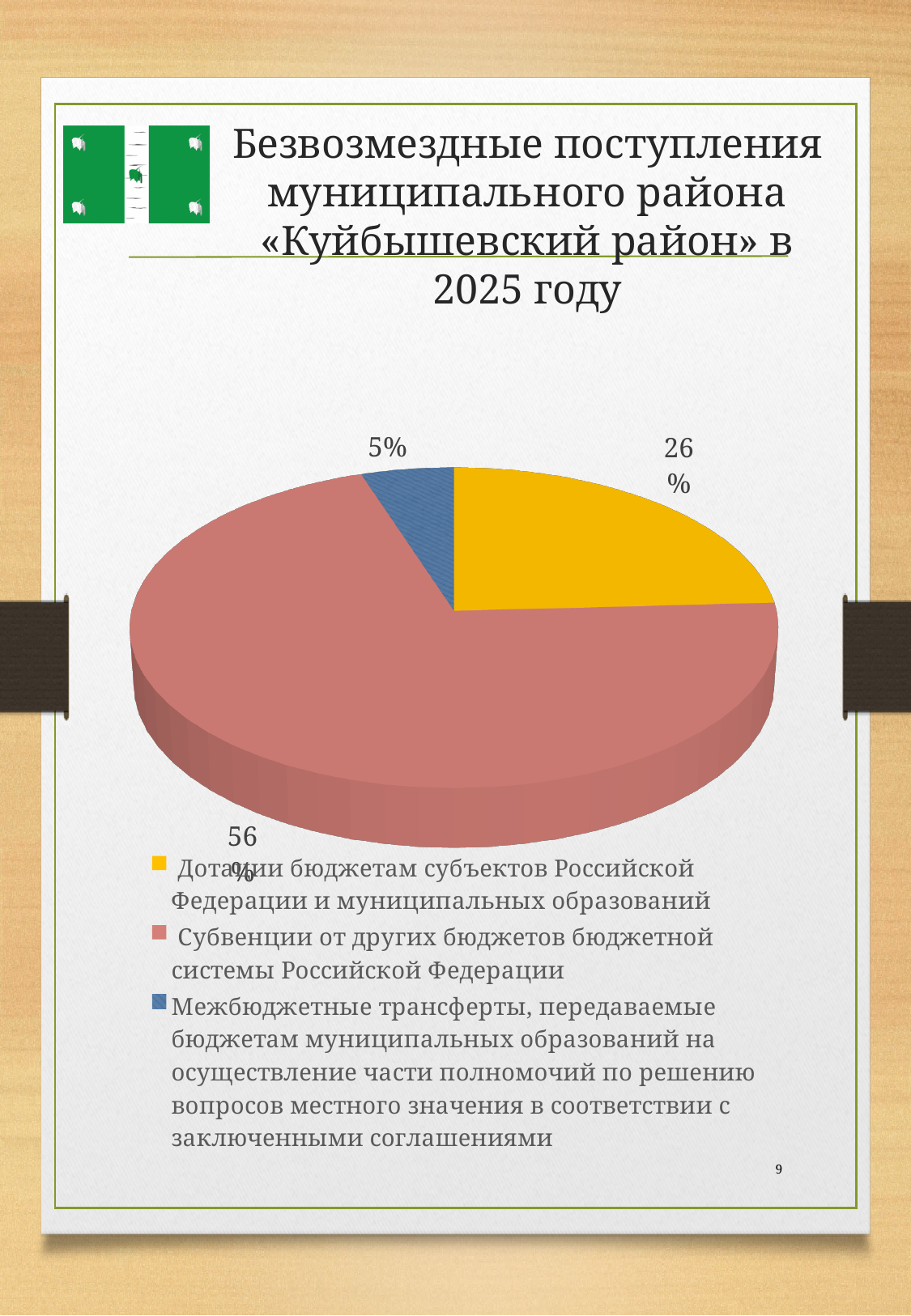
Which category has the largest slice of the pie? Субвенции от других бюджетов бюджетной системы Российской Федерации What percentage is shown for «Дотации бюджетам субъектов Российской Федерации и муниципальных образований»? 26% Which is larger: the share for «Дотации» or the share for «Межбюджетные трансферты»? Дотации How many entries does the legend list? 3 What percentage is shown for «Межбюджетные трансферты, передаваемые бюджетам муниципальных образований...»? 5% What is the title of the slide containing the pie chart? Безвозмездные поступления муниципального района «Куйбышевский район» в 2025 году How many slices does the pie chart have? 3 What colour is the slice for «Субвенции от других бюджетов бюджетной системы Российской Федерации»? Pink (red) What percentage is shown for «Субвенции от других бюджетов бюджетной системы Российской Федерации»? 56% Which category has the smallest slice of the pie? Межбюджетные трансферты, передаваемые бюджетам муниципальных образований What is the difference between the percentage for «Субвенции» and the percentage for «Дотации»? 30 percentage points What kind of chart is shown on the slide? Pie chart